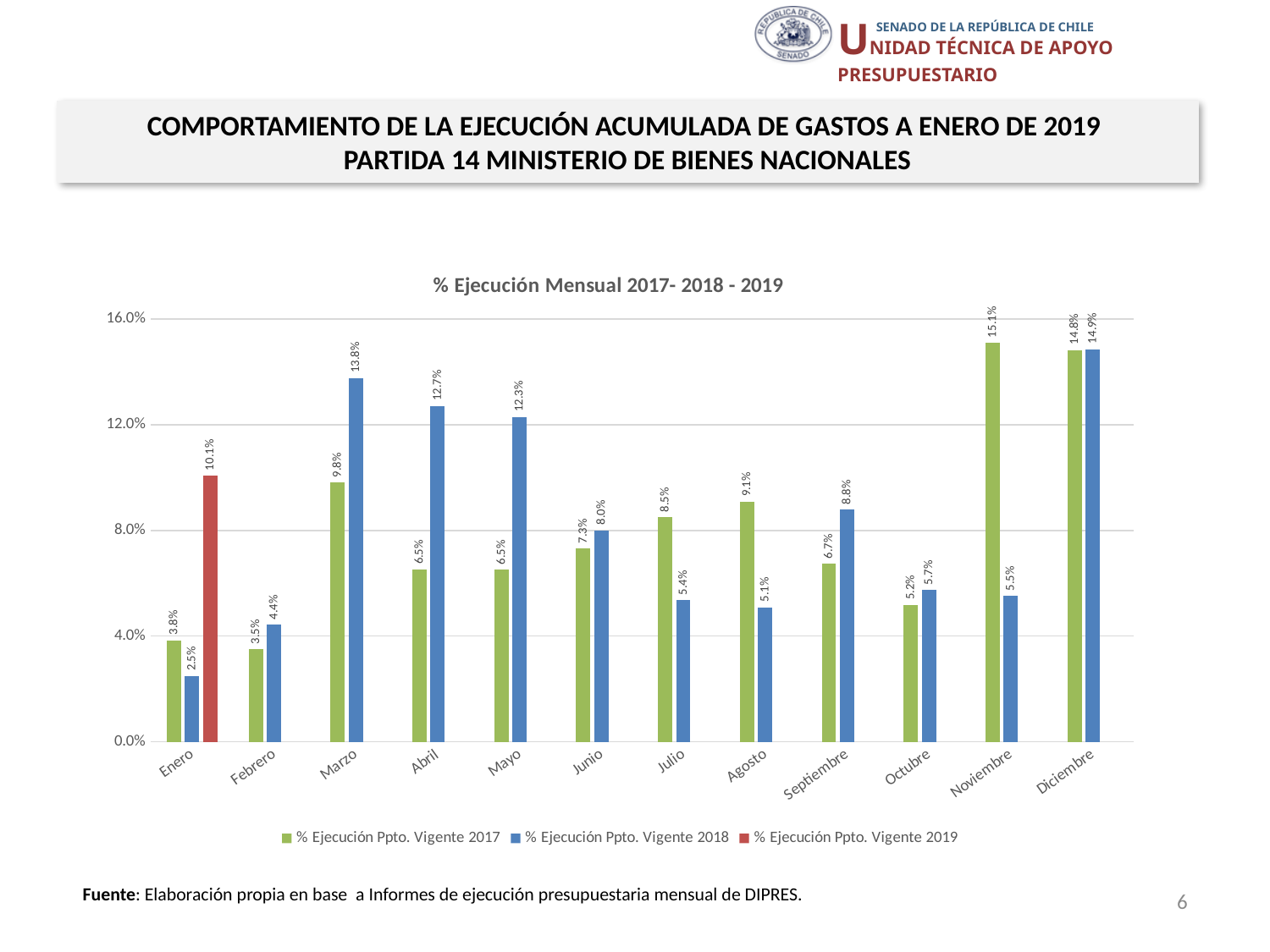
How many months are shown on the x axis? 12 Which month has the highest value for % Ejecución Ppto. Vigente 2017? Noviembre How many series does the legend list? 3 Which month has the lowest value for % Ejecución Ppto. Vigente 2018? Enero In Julio, which series has the larger value, % Ejecución Ppto. Vigente 2017 or % Ejecución Ppto. Vigente 2018? % Ejecución Ppto. Vigente 2017 What is the value for % Ejecución Ppto. Vigente 2017 in Agosto? 9.1% What is the value for % Ejecución Ppto. Vigente 2018 in Marzo? 13.8% What is the title of the chart? % Ejecución Mensual 2017- 2018 - 2019 What kind of chart is shown on the slide? Bar chart What is the value for % Ejecución Ppto. Vigente 2019 in Enero? 10.1% What is the difference between the 2018 and 2017 values in Abril? 6.2% Is the value for % Ejecución Ppto. Vigente 2018 in Mayo greater or less than 12.0%? greater